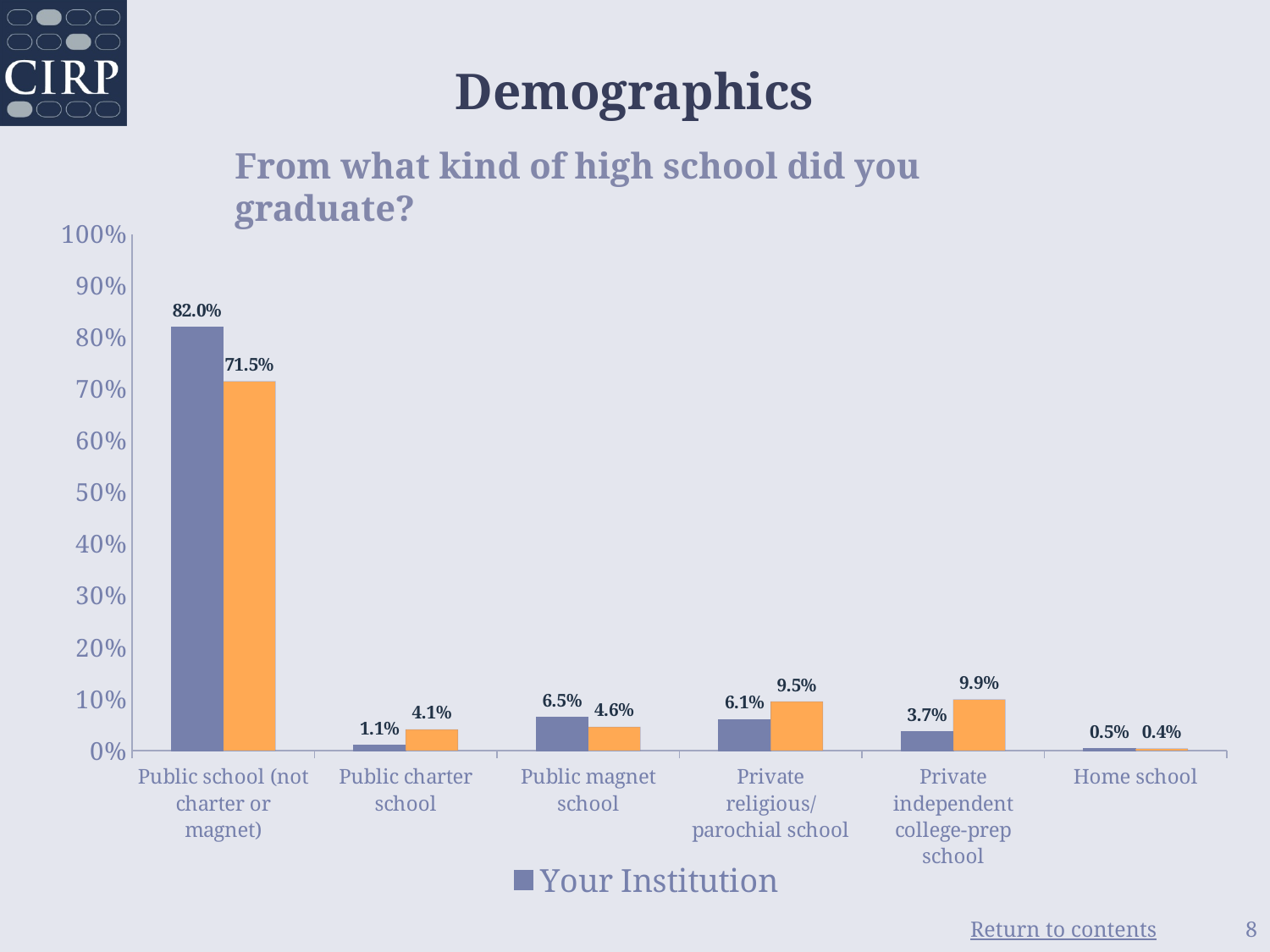
For Public charter school, which is larger: the Your Institution value or the orange bar's value? the orange bar's value How many high school types are shown on the x axis? 6 What value does the orange bar show for Private religious/parochial school? 9.5% Which high school type has the highest Your Institution value? Public school (not charter or magnet) For Public school (not charter or magnet), how much higher is the Your Institution value than the orange bar's value? 10.5 percentage points For Private independent college-prep school, what is the difference between the orange bar's value and the Your Institution value? 6.2 percentage points What is the question shown as the chart's title? From what kind of high school did you graduate? What kind of chart is shown on the slide? bar chart Which high school type has the lowest Your Institution value? Home school What is the Your Institution value for Private independent college-prep school? 3.7% What is the Your Institution value for Public school (not charter or magnet)? 82.0% What value does the orange bar show for Home school? 0.4%